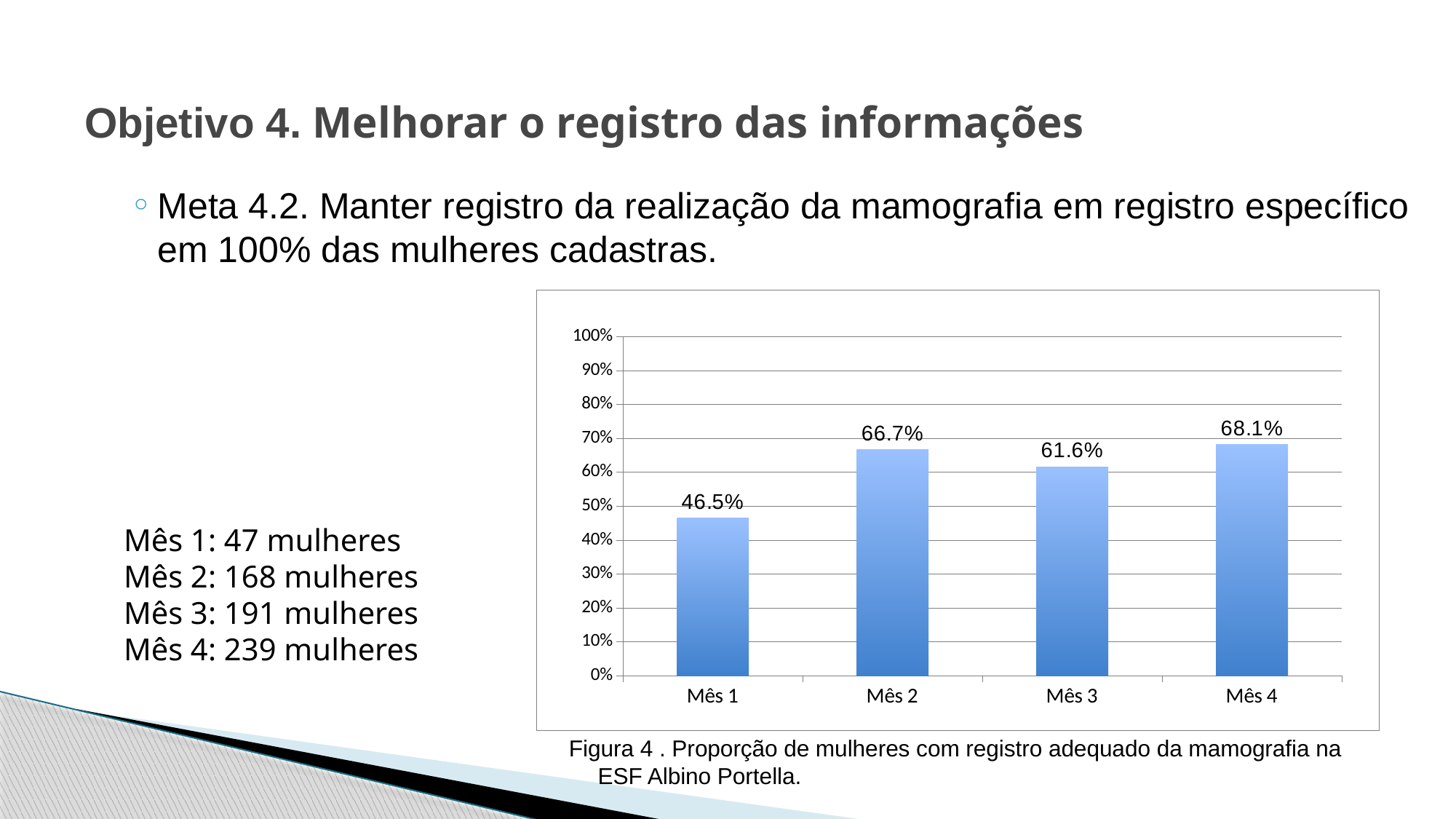
What is the difference between the values for Mês 2 and Mês 1? 20.2% What is the value for Mês 4? 68.1% What kind of chart is shown? bar chart Which month has the highest value? Mês 4 How many months are shown on the x axis? 4 What is the figure caption below the chart? Figura 4 . Proporção de mulheres com registro adequado da mamografia na ESF Albino Portella. What is the value for Mês 2? 66.7% Is the value for Mês 1 greater or less than 50%? less What is the value for Mês 3? 61.6% Which is larger, the value for Mês 2 or the value for Mês 3? Mês 2 What is the value for Mês 1? 46.5% Which month has the lowest value? Mês 1